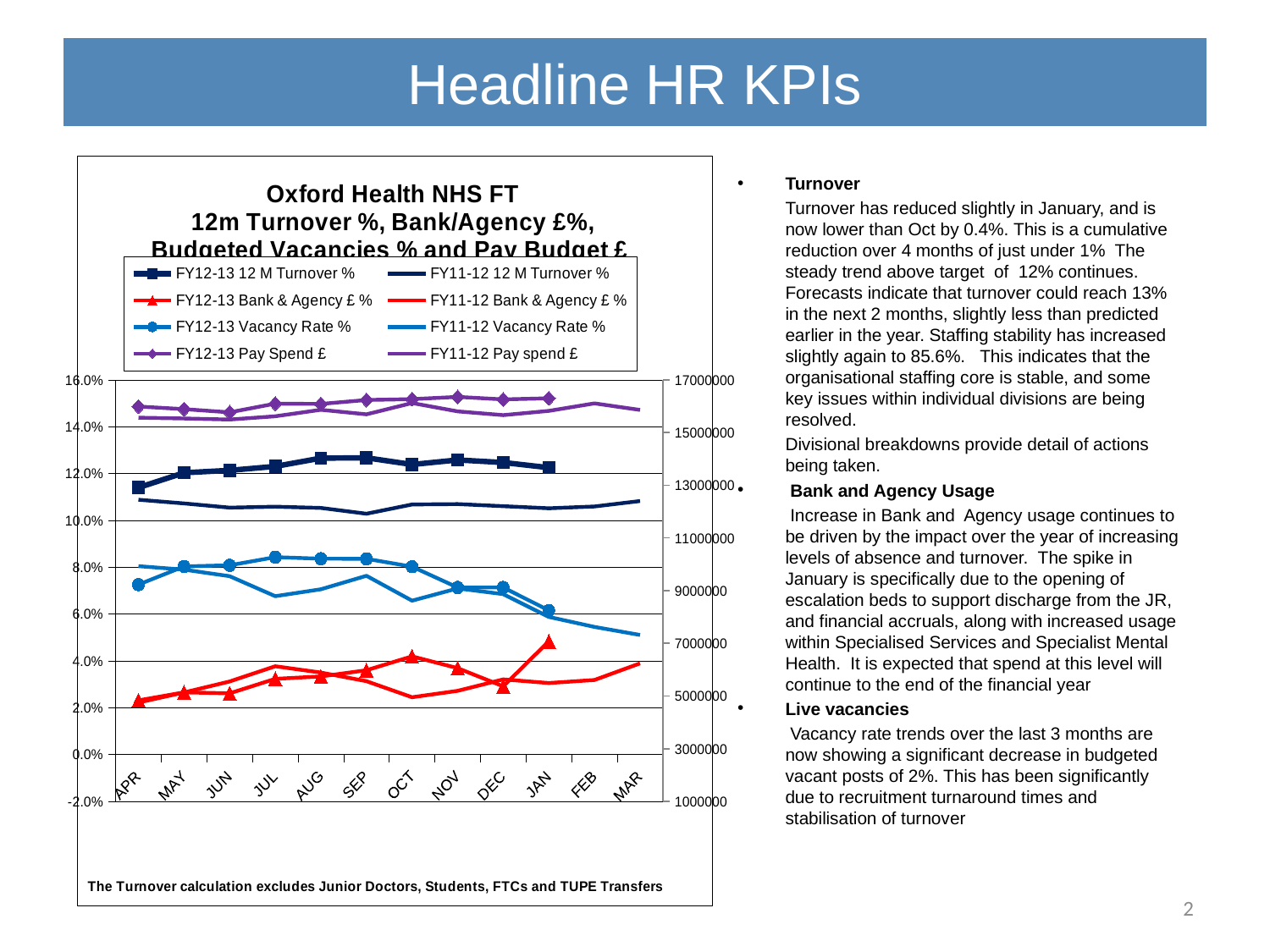
How many series does the legend list? 8 Is the value for FY11-12 Vacancy Rate % in MAR greater or less than 6.0%? less What is the first line of the chart title? Oxford Health NHS FT How many months are shown along the x axis? 12 Is the value for FY11-12 12 M Turnover % in OCT greater or less than 12.0%? less According to the note at the bottom of the chart, what does the Turnover calculation exclude? Junior Doctors, Students, FTCs and TUPE Transfers Is the value for FY12-13 Bank & Agency £ % in APR greater or less than 4.0%? less Does the FY11-12 Vacancy Rate % line generally rise or fall from APR to MAR? Fall What kind of chart is shown on the slide? Line chart In JAN, which is higher: FY12-13 12 M Turnover % or FY11-12 12 M Turnover %? FY12-13 12 M Turnover %